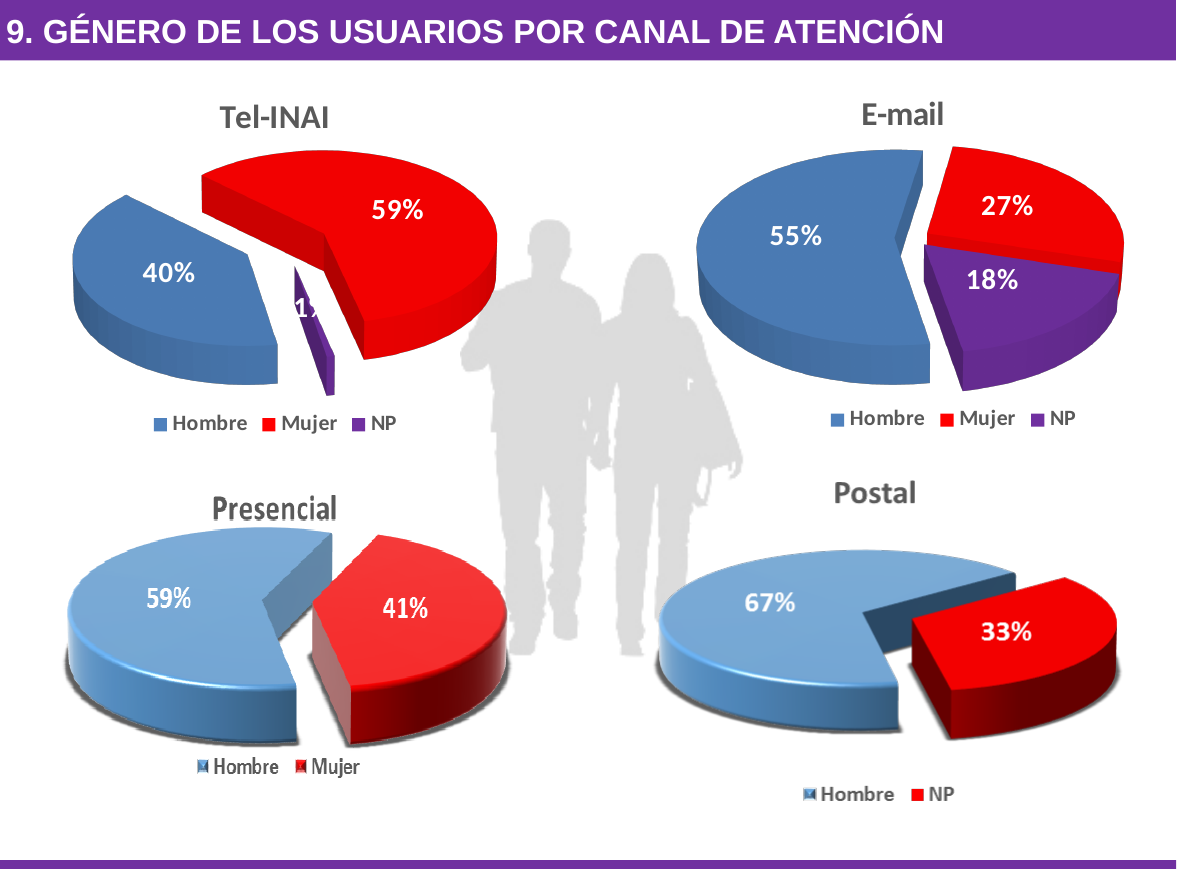
How many categories does the legend of the E-mail chart list? 3 In the Tel-INAI chart, what share of users are Mujer? 59% In the Tel-INAI chart, what share of users are Hombre? 40% In the Presencial chart, what is the difference between the Hombre and Mujer shares? 18% How many pie charts are shown on the slide? 4 In the Postal chart, what percentage is shown for Hombre? 67% In the Postal chart, which is larger, Hombre or NP? Hombre In the E-mail chart, which category has the largest share? Hombre In the E-mail chart, what percentage is shown for NP? 18% What type of chart is used for the Presencial channel? Pie chart In the E-mail chart, which category has the smallest share? NP In the E-mail chart, what percentage is shown for Mujer? 27%